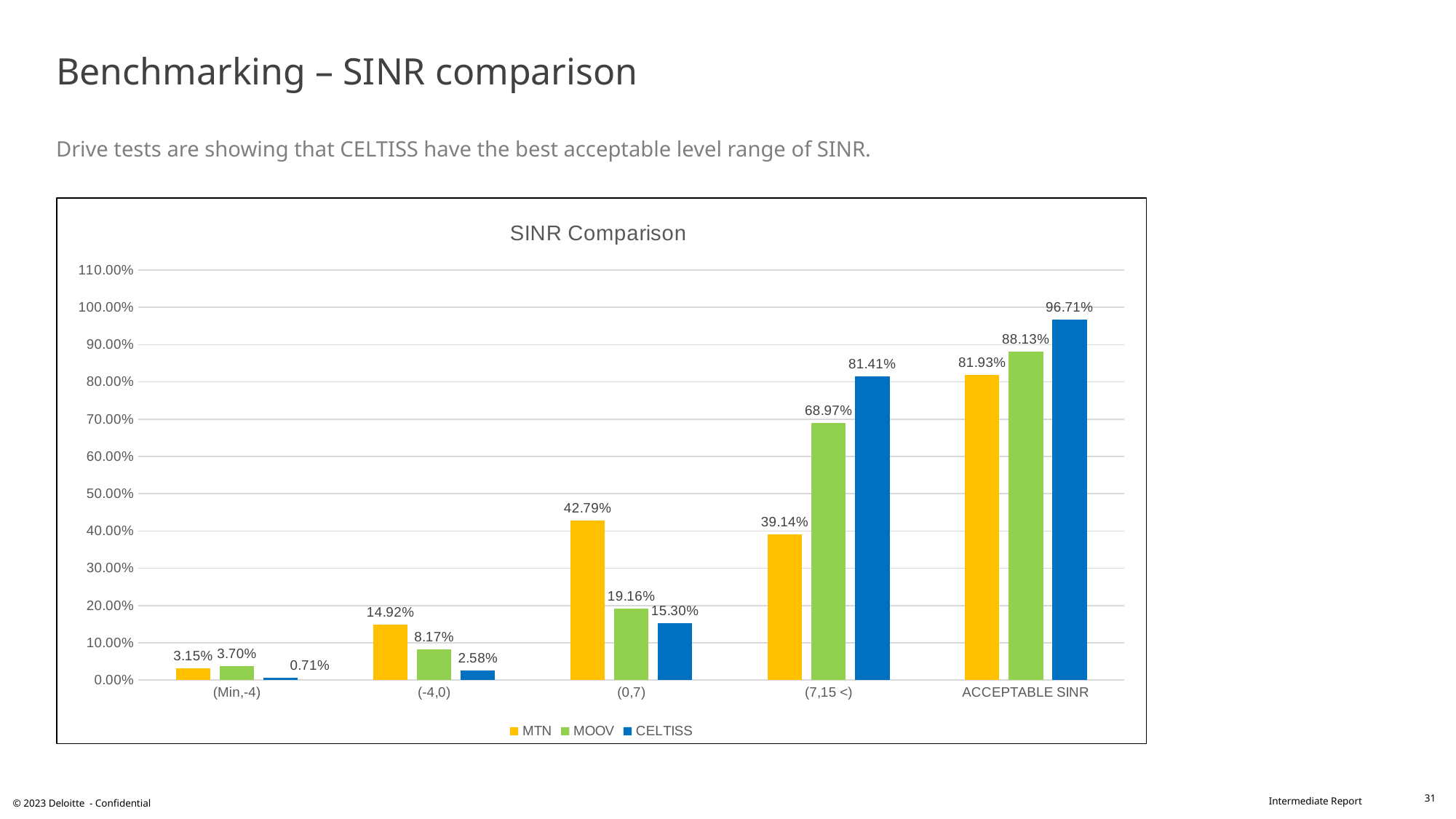
What is the difference between the CELTISS and MTN values in the ACCEPTABLE SINR category? 14.78% How many categories are shown on the x axis? 5 Is the value for MTN in the (7,15 <) category greater or less than 40.00%? less What is the value for MTN in the (0,7) category? 42.79% What is the value for CELTISS in the ACCEPTABLE SINR category? 96.71% What is the title of the chart? SINR Comparison What kind of chart is shown on the slide? Bar chart In the (0,7) category, which is larger, the MOOV value or the CELTISS value? MOOV How many series does the legend list? 3 Which series has the lowest value in the (Min,-4) category? CELTISS Which series has the highest value in the ACCEPTABLE SINR category? CELTISS What is the value for MOOV in the (7,15 <) category? 68.97%